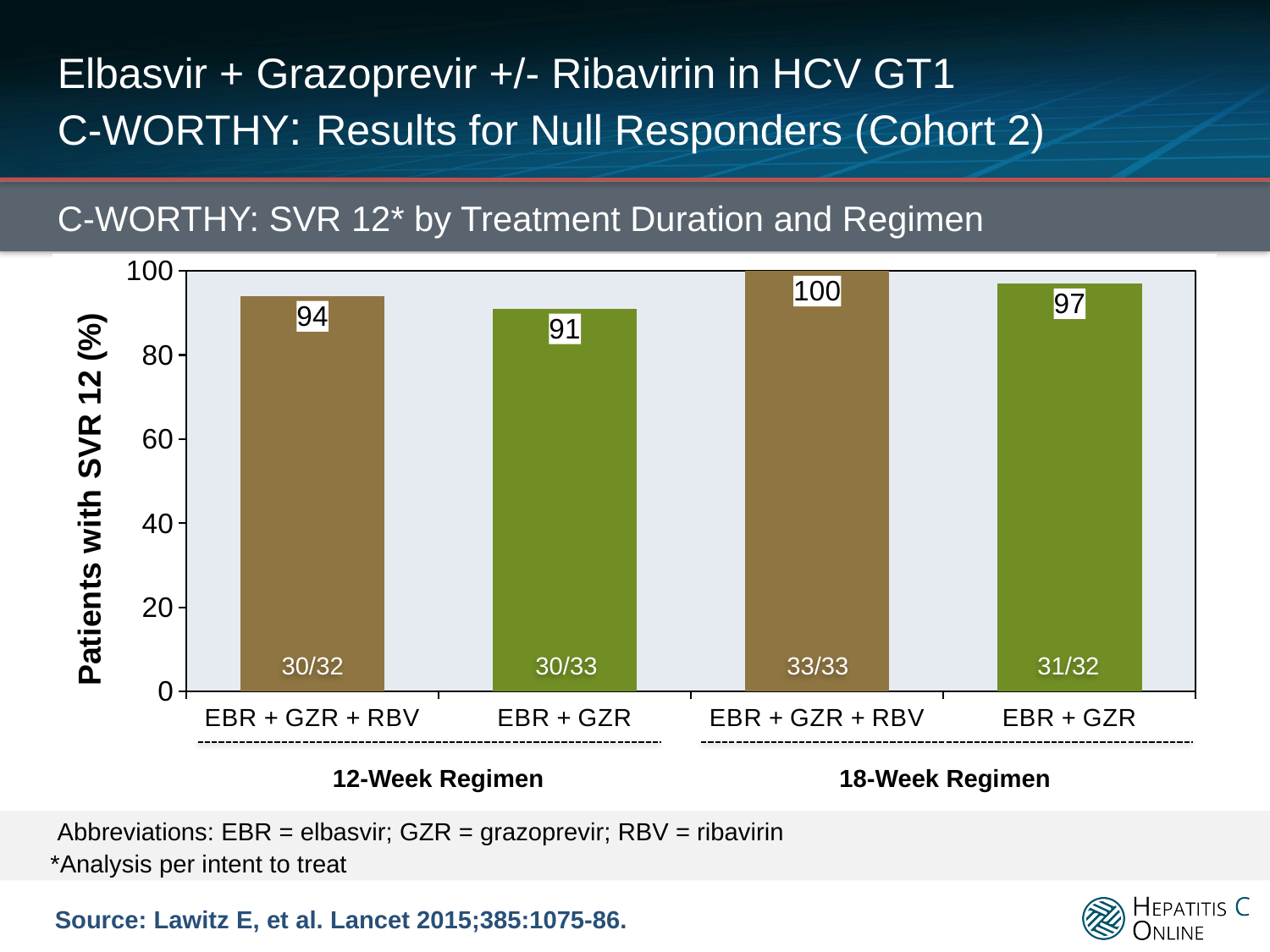
What is the difference in SVR 12 rate between the 18-Week and 12-Week EBR + GZR bars? 6 Which bar has the highest SVR 12 rate? EBR + GZR + RBV, 18-Week Regimen Which has a higher SVR 12 rate: EBR + GZR + RBV at 12 weeks or EBR + GZR at 18 weeks? EBR + GZR at 18 weeks What kind of chart is shown on the slide? Bar chart What is the difference in SVR 12 rate between EBR + GZR + RBV and EBR + GZR in the 12-Week Regimen? 3 What fraction of patients is shown inside the bar for EBR + GZR + RBV in the 18-Week Regimen? 33/33 How many bars are shown in the chart? 4 Which bar has the lowest SVR 12 rate? EBR + GZR, 12-Week Regimen What is the label of the y-axis? Patients with SVR 12 (%) What is the SVR 12 rate for EBR + GZR in the 12-Week Regimen? 91 What is the SVR 12 rate for EBR + GZR + RBV in the 12-Week Regimen? 94 What is the SVR 12 rate for EBR + GZR in the 18-Week Regimen? 97